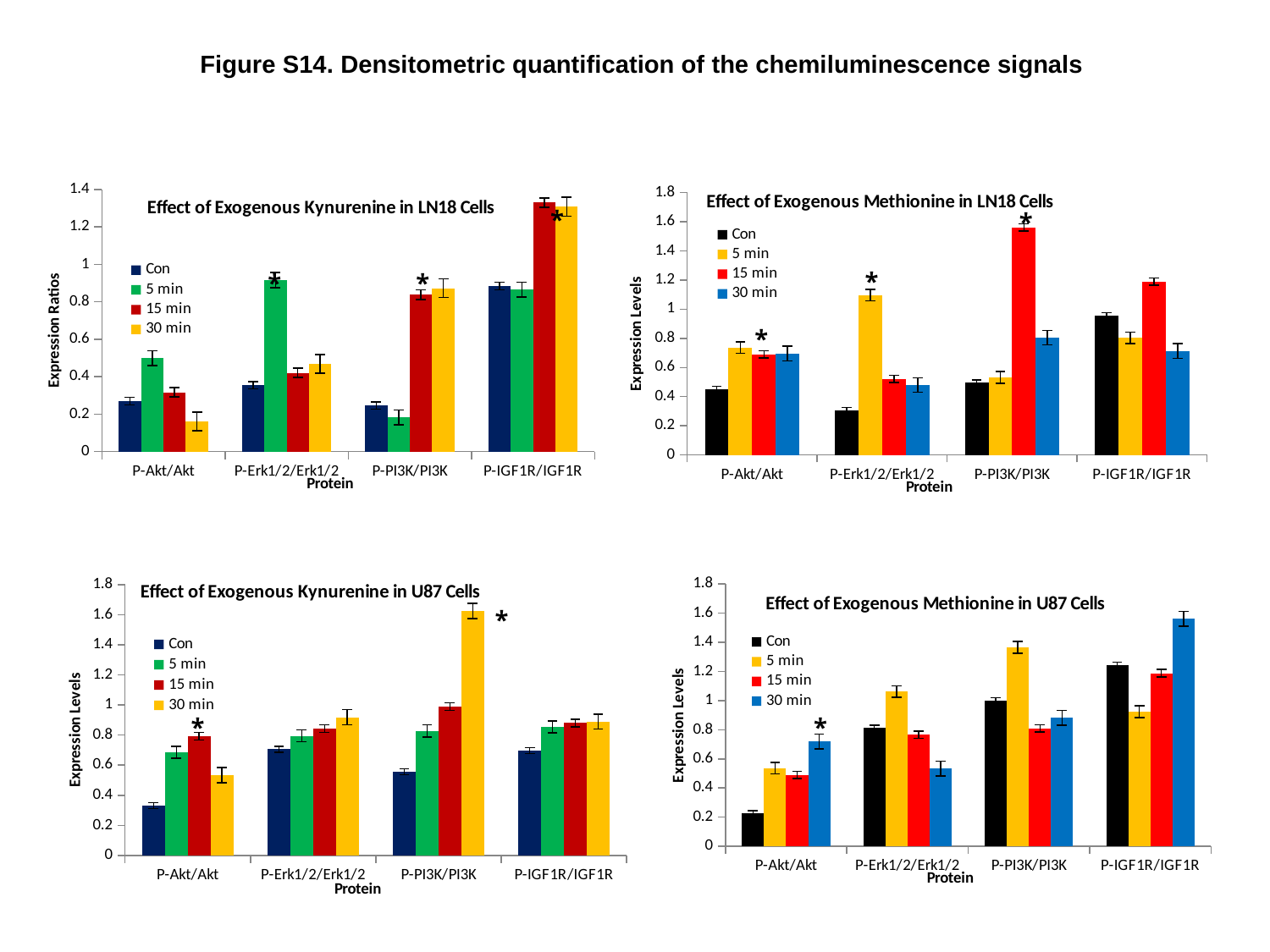
How many protein categories are shown on the x axis of the chart titled 'Effect of Exogenous Methionine in U87 Cells'? 4 In the chart titled 'Effect of Exogenous Kynurenine in LN18 Cells', is the 5 min value for P-Erk1/2/Erk1/2 greater or less than 0.8? greater In the chart titled 'Effect of Exogenous Methionine in U87 Cells', is the Con value for P-Akt/Akt greater or less than 0.4? less In the chart titled 'Effect of Exogenous Kynurenine in U87 Cells', which series has the highest bar for P-PI3K/PI3K? 30 min In the chart titled 'Effect of Exogenous Methionine in LN18 Cells', is the 15 min value for P-PI3K/PI3K greater or less than 1.4? greater In the chart titled 'Effect of Exogenous Methionine in U87 Cells', which series has the lowest bar for P-Akt/Akt? Con In the chart titled 'Effect of Exogenous Kynurenine in LN18 Cells', how many series does the legend list? 4 In the chart titled 'Effect of Exogenous Methionine in LN18 Cells', for P-Erk1/2/Erk1/2, which is larger: the 5 min value or the 15 min value? 5 min In the chart titled 'Effect of Exogenous Methionine in LN18 Cells', which protein has the tallest bar overall? P-PI3K/PI3K What type of chart is 'Effect of Exogenous Kynurenine in LN18 Cells'? bar chart In the chart titled 'Effect of Exogenous Kynurenine in LN18 Cells', which series has the highest bar for P-IGF1R/IGF1R? 15 min